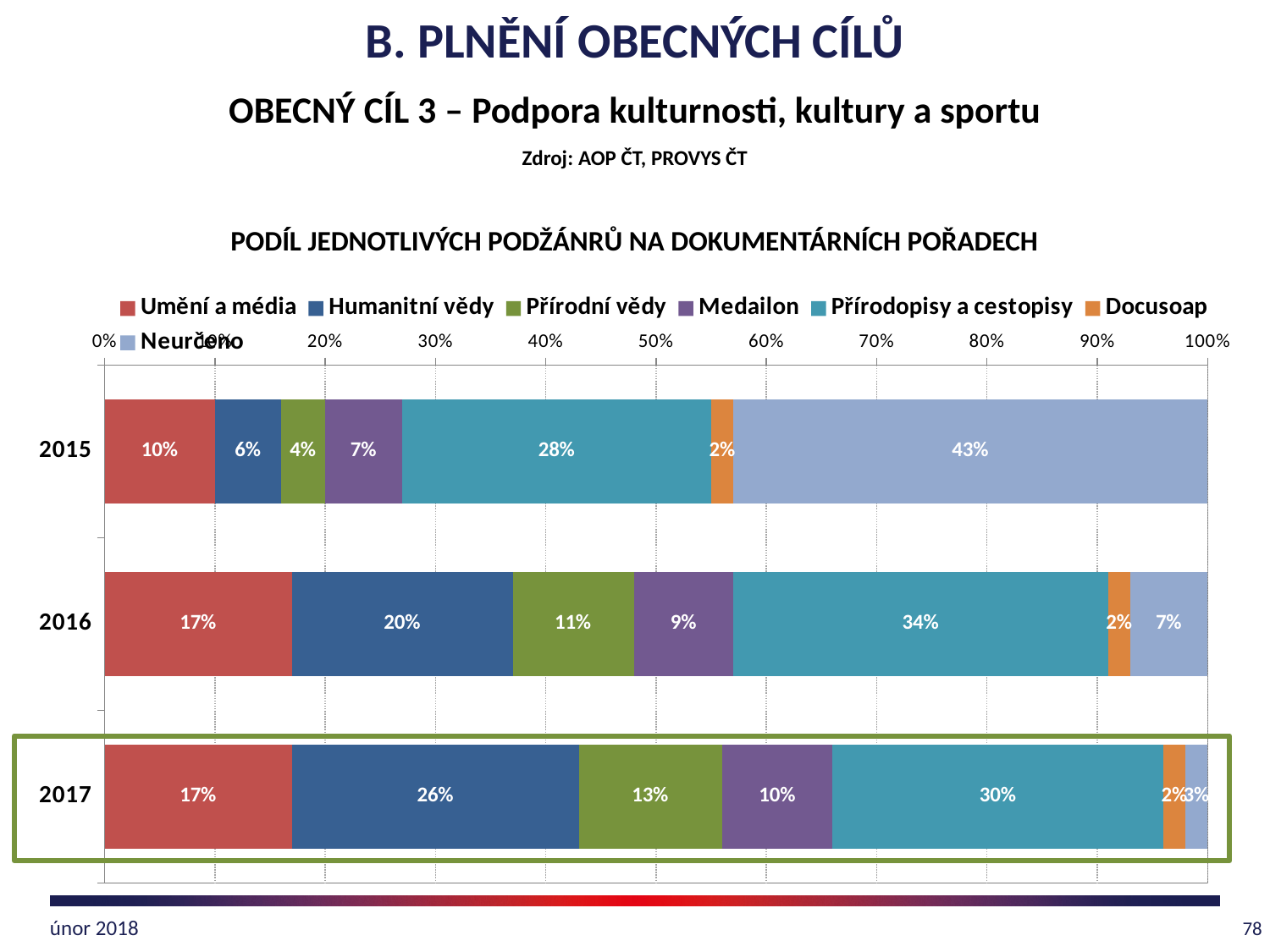
What is the share of Humanitní vědy in 2017? 26% In which year is the share of Neurčeno the highest? 2015 Does the share of Umění a média rise or fall from 2015 to 2016? Rise What is the title of the chart? PODÍL JEDNOTLIVÝCH PODŽÁNRŮ NA DOKUMENTÁRNÍCH POŘADECH What is the difference between the share of Přírodní vědy in 2017 and in 2015? 9 percentage points Which is larger: the share of Medailon in 2016 or in 2017? 2017 How many series does the legend list? 7 What is the share of Neurčeno in 2015? 43% What is the share of Přírodopisy a cestopisy in 2016? 34% What type of chart is shown on the slide? Stacked bar chart In which year is the share of Humanitní vědy the lowest? 2015 How many years (categories) are plotted on the chart? 3